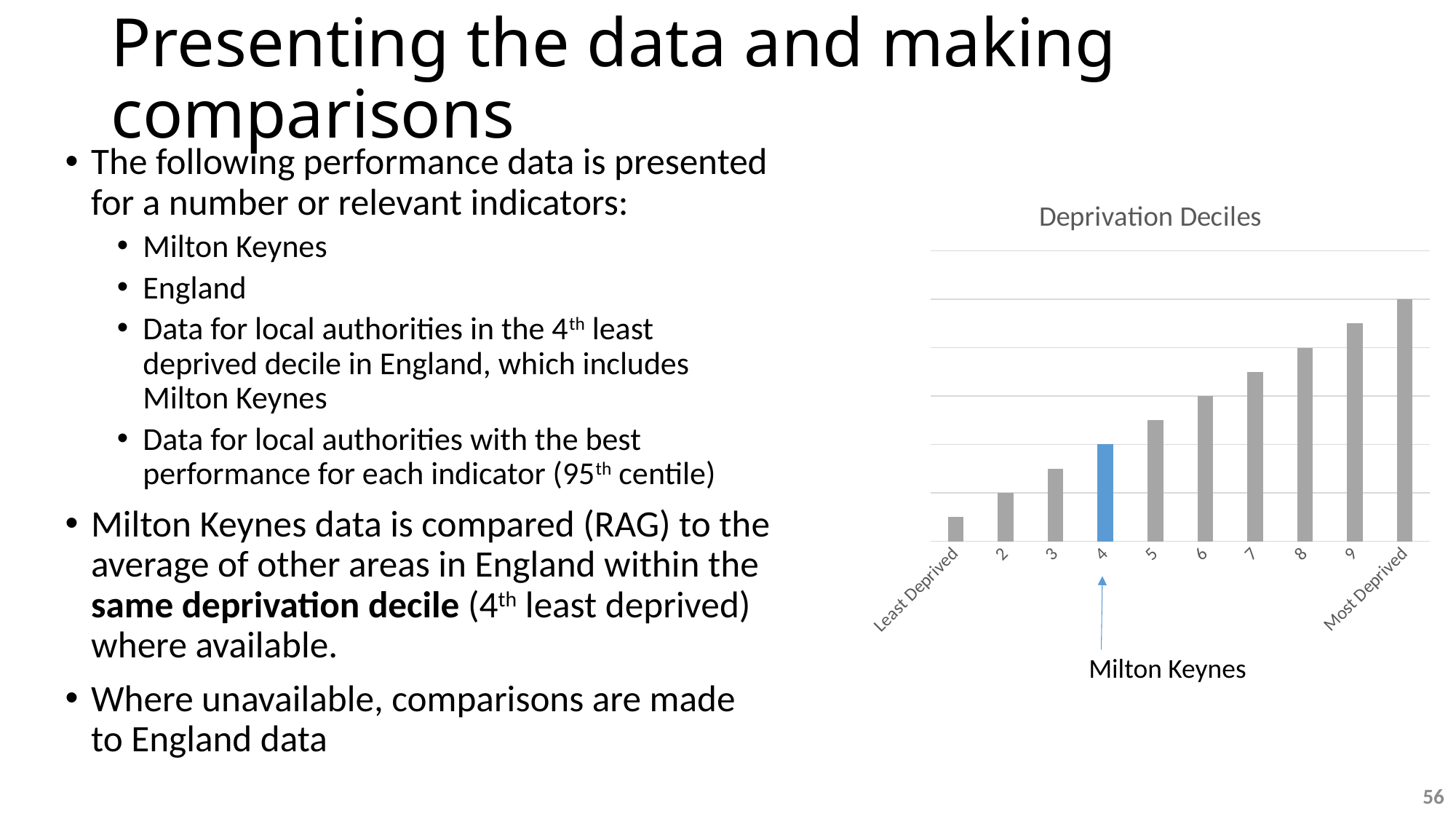
What is the label of the first category on the x axis? Least Deprived Which bar in the chart is highlighted in blue? 4 Which bar is taller, decile 4 or decile 7? 7 Which decile bar is labelled with the arrow 'Milton Keynes'? 4 Which category has the shortest bar in the Deprivation Deciles chart? Least Deprived What is the title of the chart? Deprivation Deciles Which bar is taller, decile 2 or decile 5? 5 What kind of chart is shown on the slide? bar chart How many bars are plotted in the Deprivation Deciles chart? 10 What is the label of the last category on the x axis? Most Deprived Do the bar heights rise or fall from Least Deprived to Most Deprived? rise Which category has the tallest bar in the Deprivation Deciles chart? Most Deprived